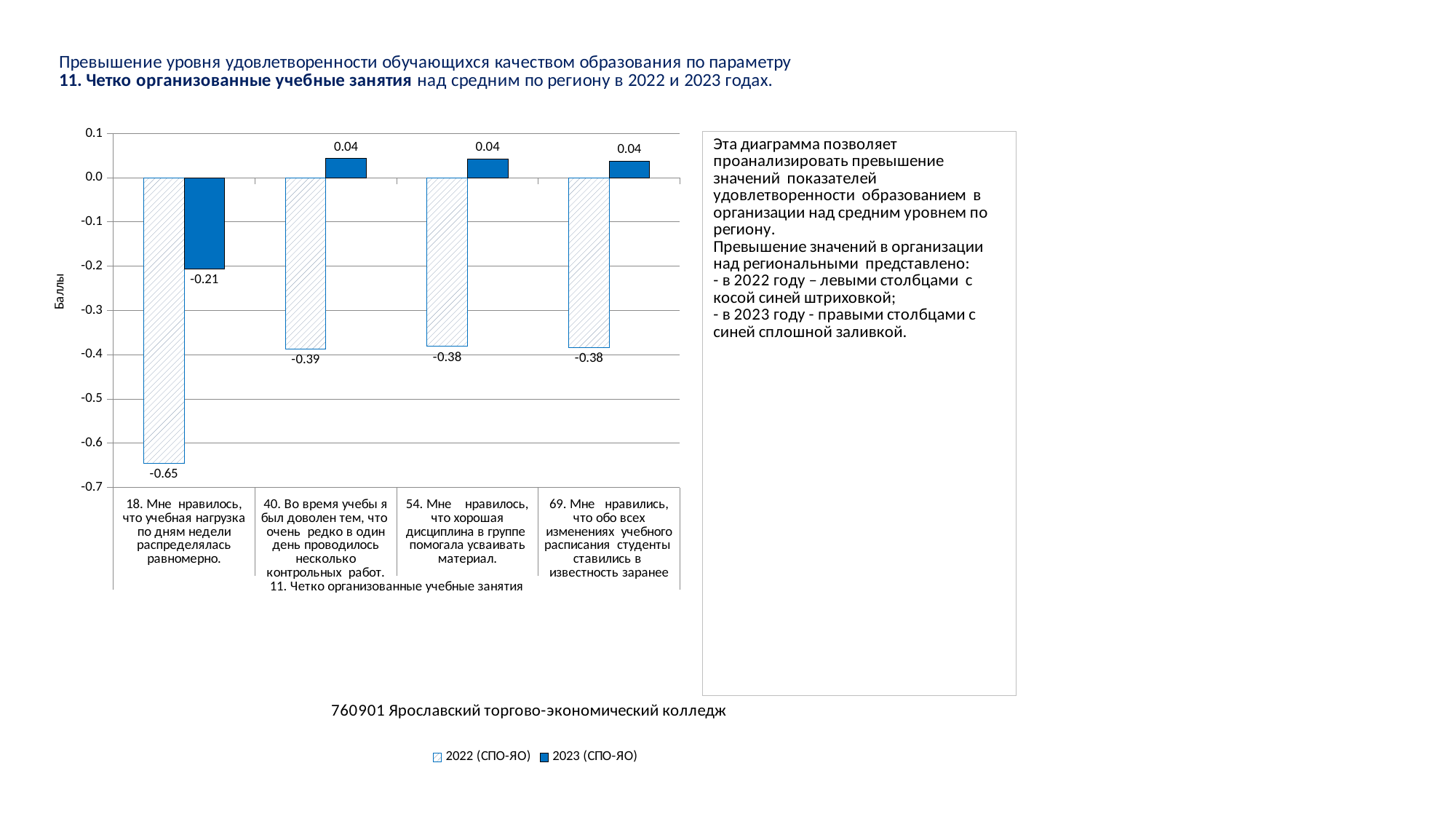
Каково значение 2022 (СПО-ЯО) для категории «18. Мне нравилось, что учебная нагрузка по дням недели распределялась равномерно.»? -0.65 На сколько значение 2023 (СПО-ЯО) больше значения 2022 (СПО-ЯО) для категории «18. Мне нравилось, что учебная нагрузка по дням недели распределялась равномерно.»? 0.44 Каково значение 2022 (СПО-ЯО) для категории «40. Во время учебы я был доволен тем, что очень редко в один день проводилось несколько контрольных работ.»? -0.39 Каково значение 2023 (СПО-ЯО) для категории «18. Мне нравилось, что учебная нагрузка по дням недели распределялась равномерно.»? -0.21 Сколько категорий показано на диаграмме? 4 Какого типа эта диаграмма? Столбчатая (bar chart) Каково значение 2023 (СПО-ЯО) для категории «54. Мне нравилось, что хорошая дисциплина в группе помогала усваивать материал.»? 0.04 Какое значение 2022 (СПО-ЯО) больше: для категории 18 или для категории 40? Категория 40 Для какой категории значение 2023 (СПО-ЯО) самое низкое? 18. Мне нравилось, что учебная нагрузка по дням недели распределялась равномерно. Для какой категории значение 2022 (СПО-ЯО) самое низкое? 18. Мне нравилось, что учебная нагрузка по дням недели распределялась равномерно. Сколько рядов данных указано в легенде диаграммы? 2 На сколько значение 2023 (СПО-ЯО) больше значения 2022 (СПО-ЯО) для категории «40. Во время учебы я был доволен тем, что очень редко в один день проводилось несколько контрольных работ.»? 0.43